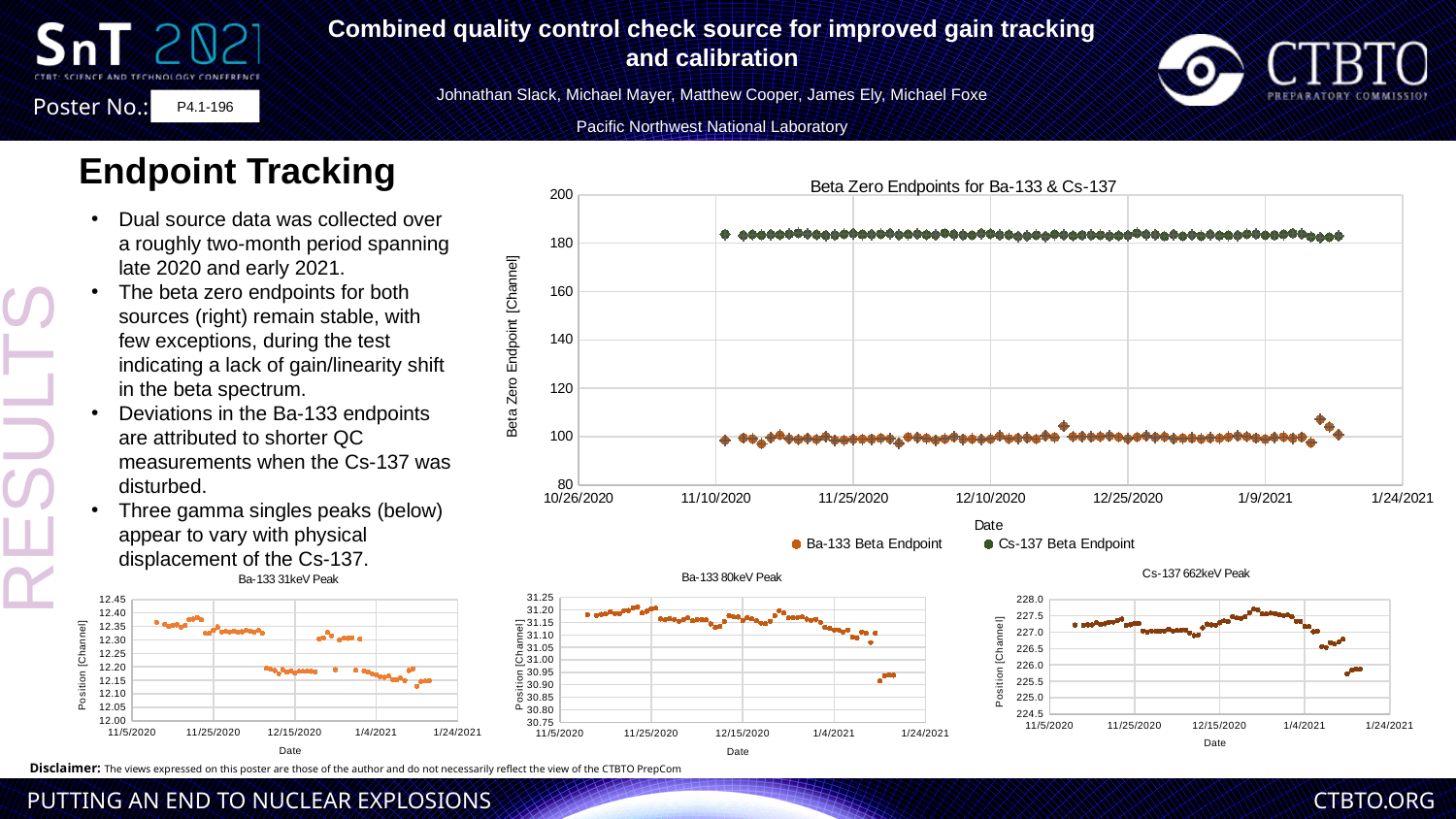
In the 'Beta Zero Endpoints for Ba-133 & Cs-137' chart, are the Cs-137 Beta Endpoint values greater or less than 160? greater In the 'Ba-133 31keV Peak' chart, do the values generally rise or fall from November 2020 to January 2021? fall In the 'Cs-137 662keV Peak' chart, are the latest values (mid-January 2021) greater or less than 226.5? less In the 'Beta Zero Endpoints for Ba-133 & Cs-137' chart, what is the label of the vertical axis? Beta Zero Endpoint [Channel] In the 'Beta Zero Endpoints for Ba-133 & Cs-137' chart, what are the two legend entries? Ba-133 Beta Endpoint and Cs-137 Beta Endpoint In the 'Ba-133 80keV Peak' chart, do the values generally rise or fall from November 2020 to January 2021? fall In the 'Cs-137 662keV Peak' chart, do the values generally rise or fall from November 2020 to January 2021? fall What kind of chart is the 'Beta Zero Endpoints for Ba-133 & Cs-137' chart? scatter chart In the 'Beta Zero Endpoints for Ba-133 & Cs-137' chart, are the Ba-133 Beta Endpoint values greater or less than 120? less In the 'Beta Zero Endpoints for Ba-133 & Cs-137' chart, how many series does the legend list? 2 In the 'Beta Zero Endpoints for Ba-133 & Cs-137' chart, which series has the higher values, Ba-133 Beta Endpoint or Cs-137 Beta Endpoint? Cs-137 Beta Endpoint